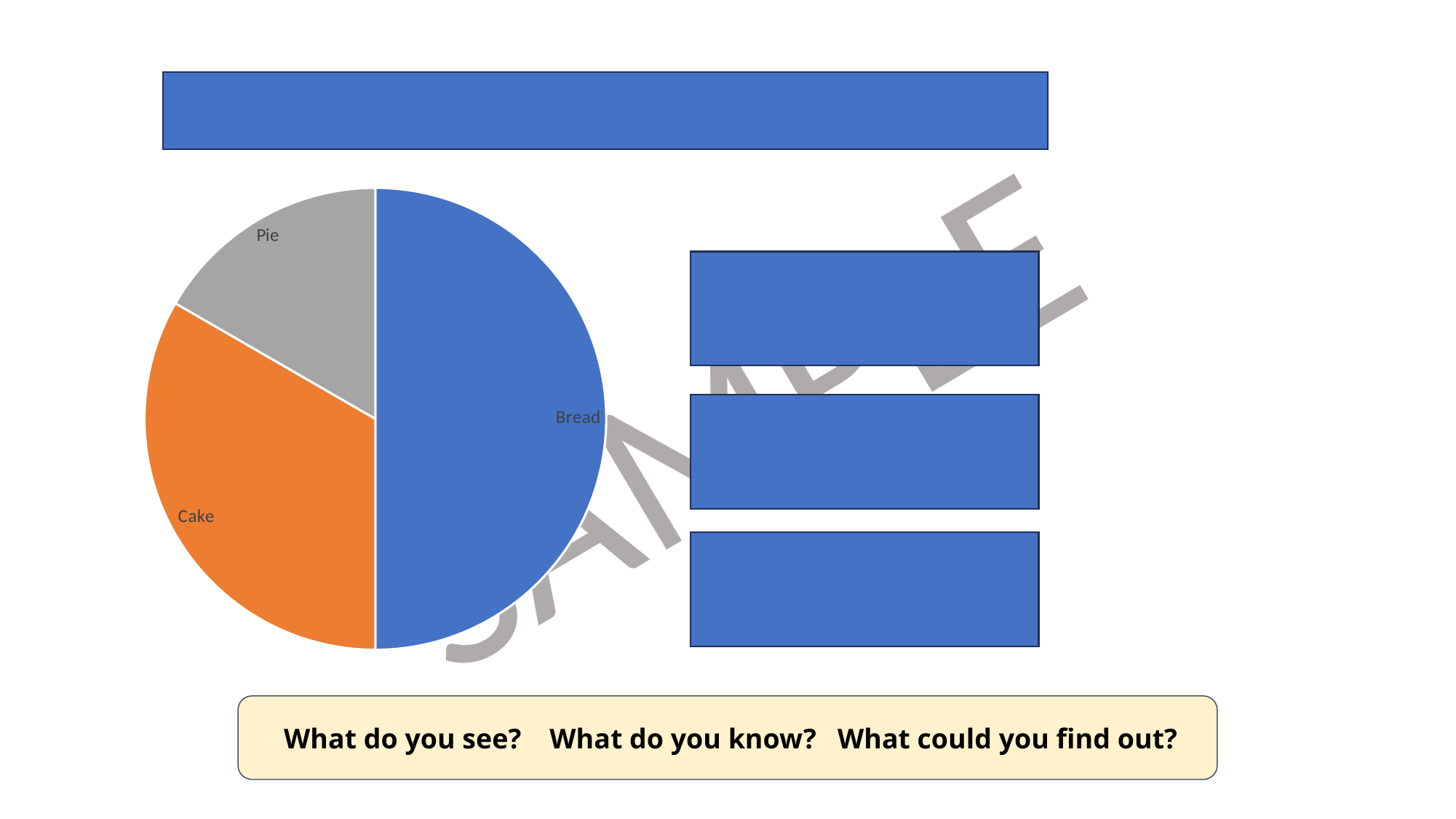
What colour is the Cake slice in the pie chart? orange Which slice is larger, Cake or Pie? Cake What kind of chart is shown on the slide? pie chart How many slices does the pie chart have? 3 Which slice is larger, Bread or Cake? Bread Which category has the smallest slice of the pie chart? Pie Which slice is smaller, Bread or Pie? Pie Which category is shown in blue in the pie chart? Bread Which category has the largest slice of the pie chart? Bread